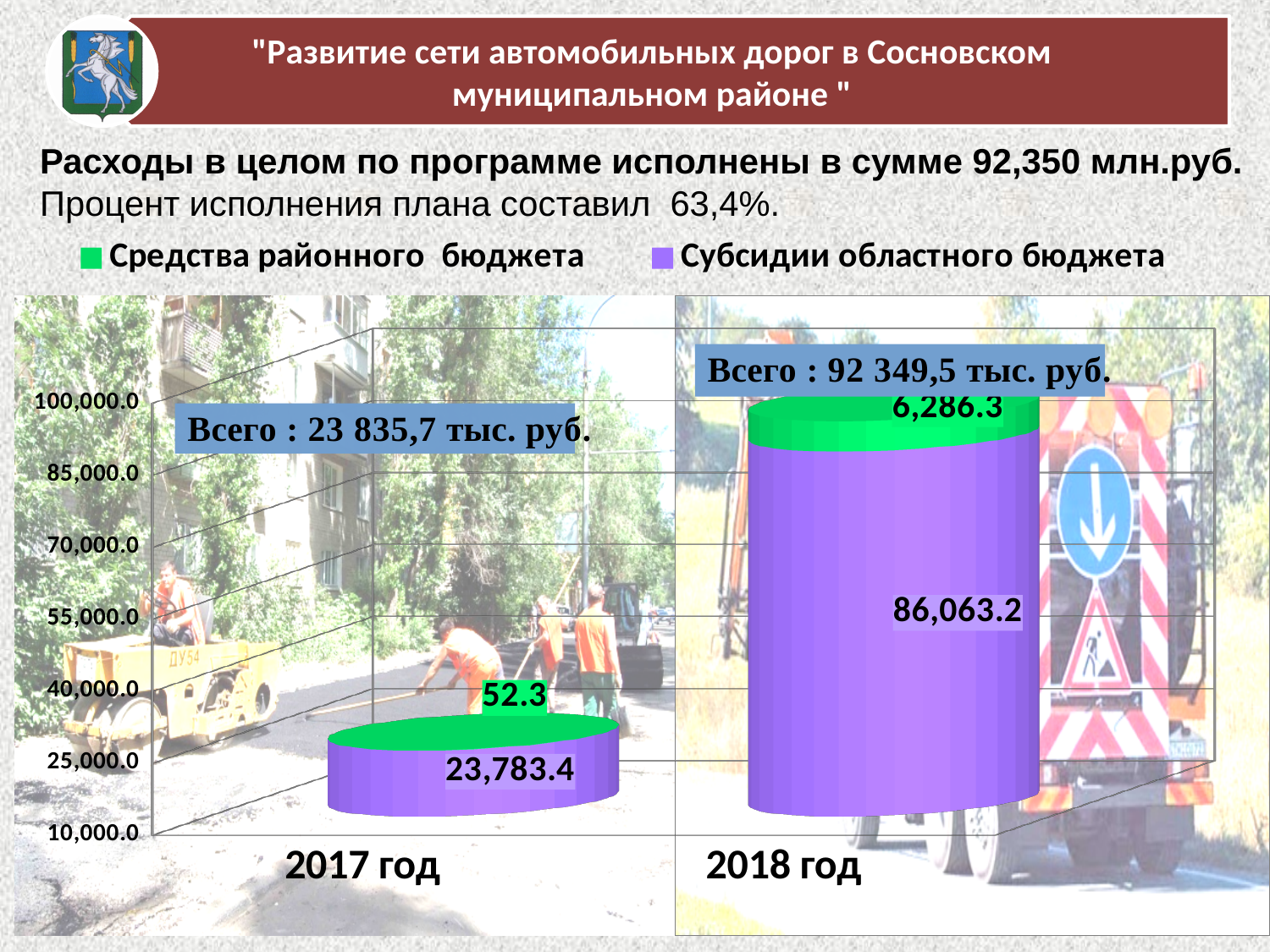
Which year has the higher value for Субсидии областного бюджета? 2018 год Which year has the lower value for Средства районного бюджета? 2017 год How many series does the legend list? 2 How many categories are shown on the x axis? 2 What total is shown for 2018 год? 92 349,5 тыс. руб. What is the difference between the Субсидии областного бюджета values for 2018 год and 2017 год? 62,279.8 What is the value of Субсидии областного бюджета for 2018 год? 86,063.2 What kind of chart is shown on the slide? Stacked bar chart What is the value of Средства районного бюджета for 2018 год? 6,286.3 What total is shown for 2017 год? 23 835,7 тыс. руб. What is the value of Субсидии областного бюджета for 2017 год? 23,783.4 What is the value of Средства районного бюджета for 2017 год? 52.3